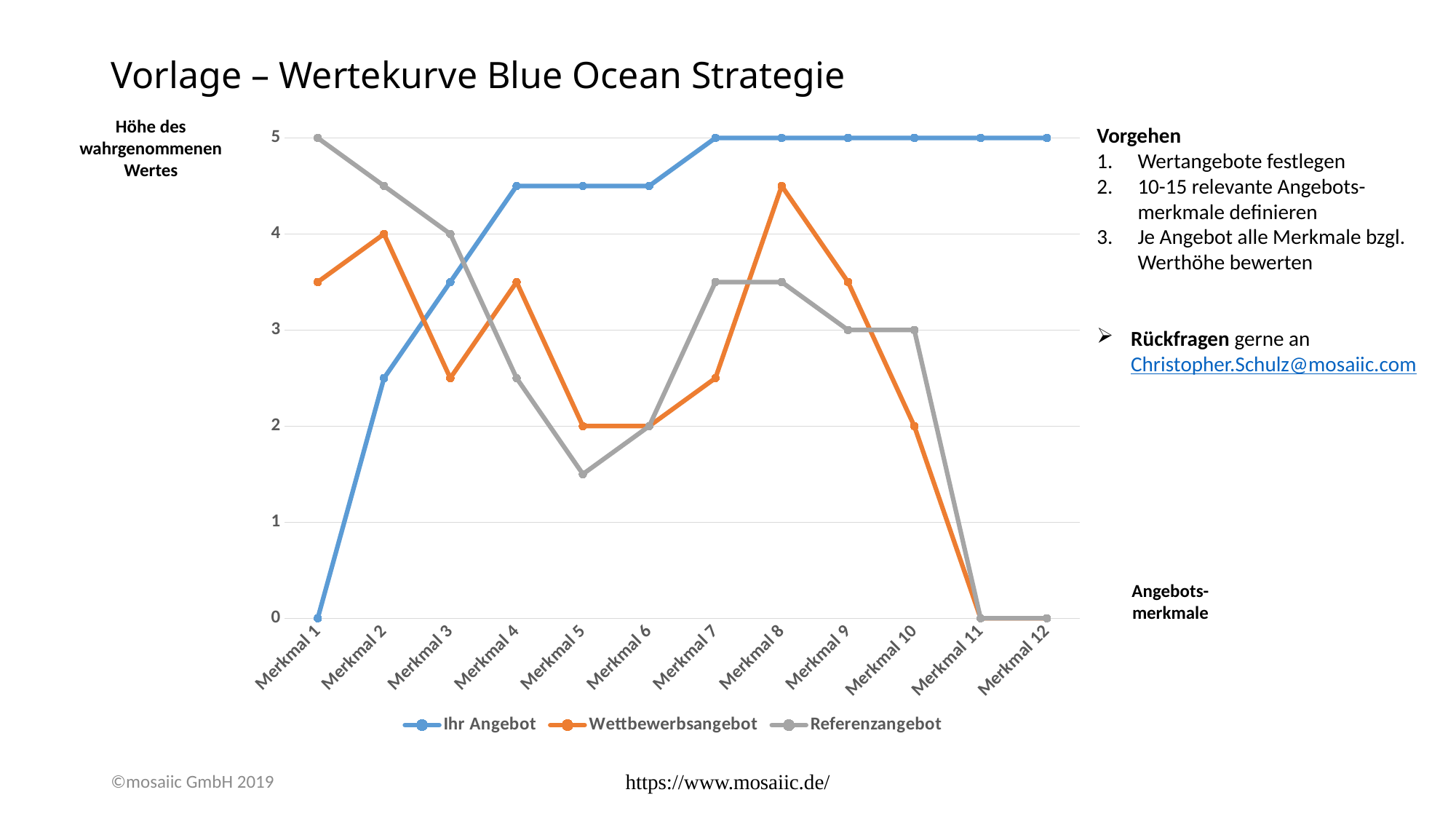
What is the value of Referenzangebot at Merkmal 11? 0 Is the value of Referenzangebot at Merkmal 5 greater or less than 2? less What kind of chart is shown on the slide? line chart Does the Ihr Angebot line rise or fall from Merkmal 1 to Merkmal 7? rise What is the value of Wettbewerbsangebot at Merkmal 2? 4 What is the value of Ihr Angebot at Merkmal 9? 5 How many categories (Merkmale) are plotted along the x axis? 12 How many series does the legend list? 3 What is the value of Ihr Angebot at Merkmal 1? 0 What is the value of Referenzangebot at Merkmal 1? 5 Is the value of Ihr Angebot at Merkmal 4 greater or less than 4? greater At Merkmal 8, which series has the higher value: Ihr Angebot or Referenzangebot? Ihr Angebot